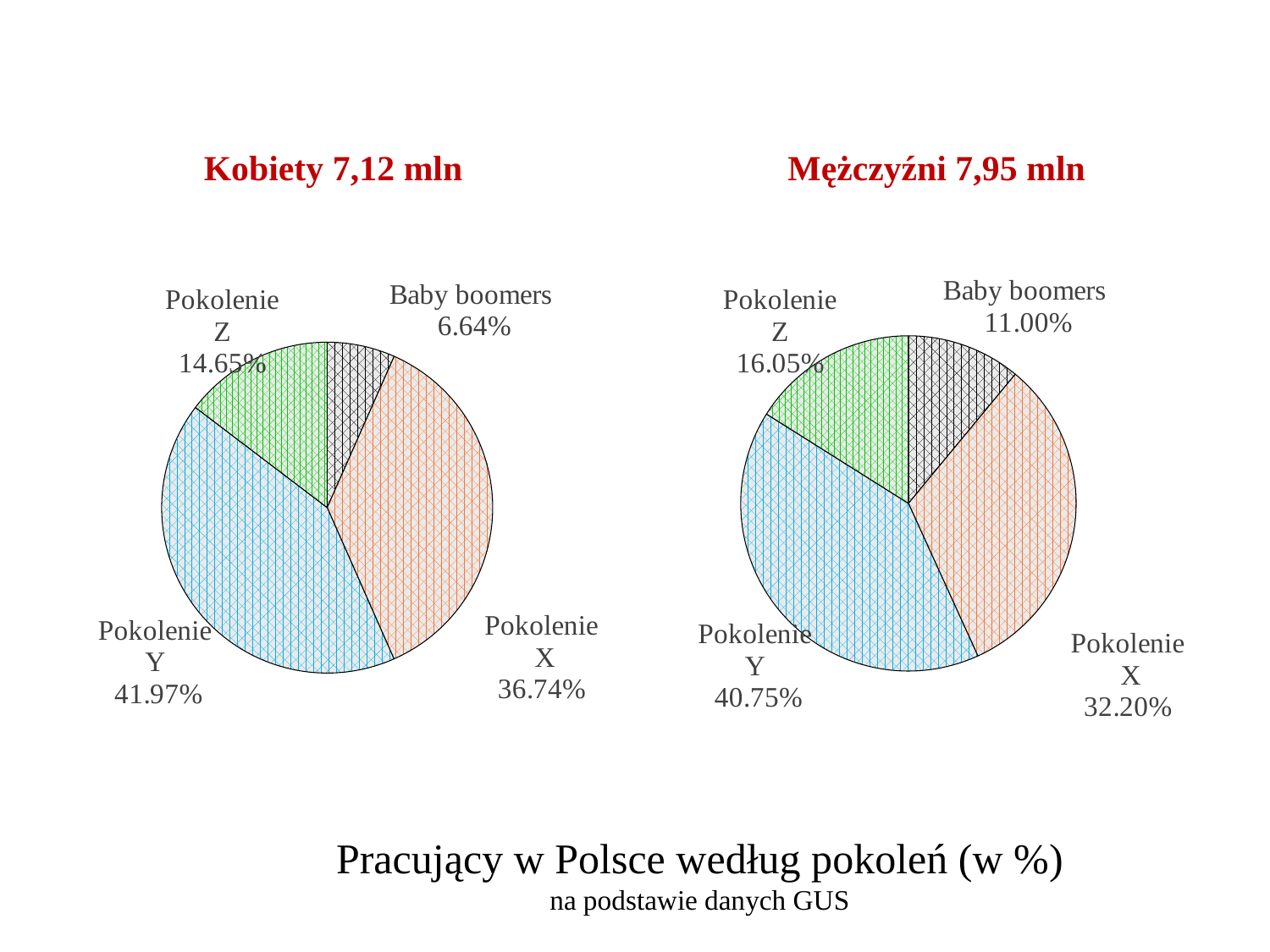
In the Mężczyźni 7,95 mln pie chart, what share does Pokolenie X have? 32.20% Which is larger: the Pokolenie Z share in the Kobiety chart or the Pokolenie Z share in the Mężczyźni chart? Mężczyźni In the Mężczyźni 7,95 mln pie chart, which generation has the smallest share? Baby boomers In the Kobiety 7,12 mln pie chart, what share does Pokolenie Z have? 14.65% What is the title shown at the bottom of the slide for the charts? Pracujący w Polsce według pokoleń (w %) How many slices does the Mężczyźni 7,95 mln pie chart have? 4 What is the difference between the Pokolenie Y shares in the Kobiety and Mężczyźni charts? 1.22% In the Mężczyźni 7,95 mln pie chart, what share does Baby boomers have? 11.00% In the Kobiety 7,12 mln pie chart, what share does Pokolenie Y have? 41.97% In the Kobiety 7,12 mln pie chart, what is the difference between the shares of Pokolenie X and Baby boomers? 30.10% In the Kobiety 7,12 mln pie chart, which generation has the largest share? Pokolenie Y What type of chart is used on the left of the slide for Kobiety 7,12 mln? Pie chart